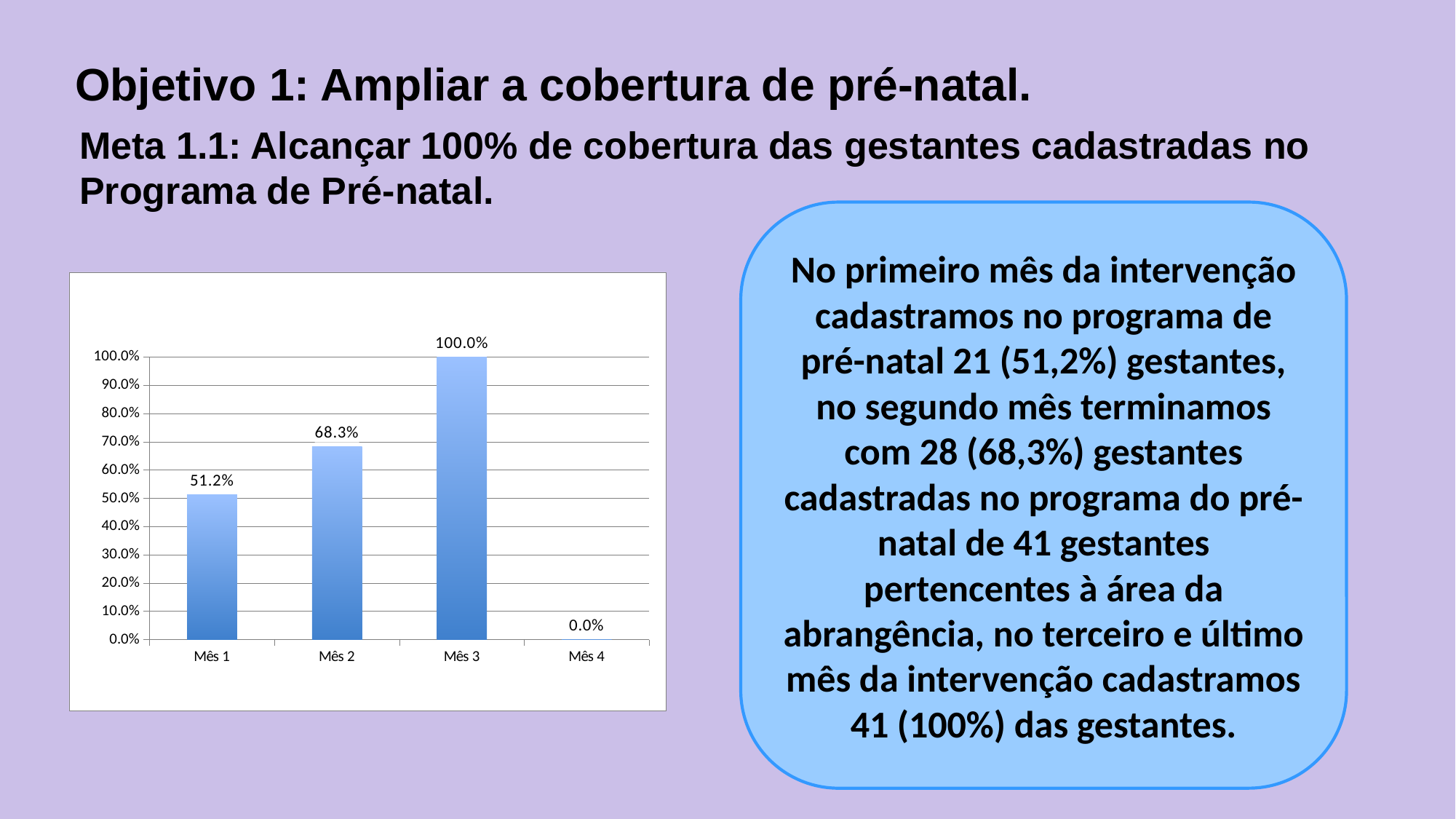
What kind of chart is shown on the slide? Bar chart Which is larger, the value for Mês 1 or the value for Mês 2? Mês 2 Do the values rise or fall from Mês 1 to Mês 3? Rise How many months are shown on the x axis of the chart? 4 Which month has the highest value? Mês 3 What is the value for Mês 3? 100.0% What is the difference between the values for Mês 3 and Mês 2? 31.7% What is the value for Mês 2? 68.3% Which month has the lowest value? Mês 4 What is the difference between the values for Mês 2 and Mês 1? 17.1% What is the value for Mês 4? 0.0% What is the value for Mês 1? 51.2%